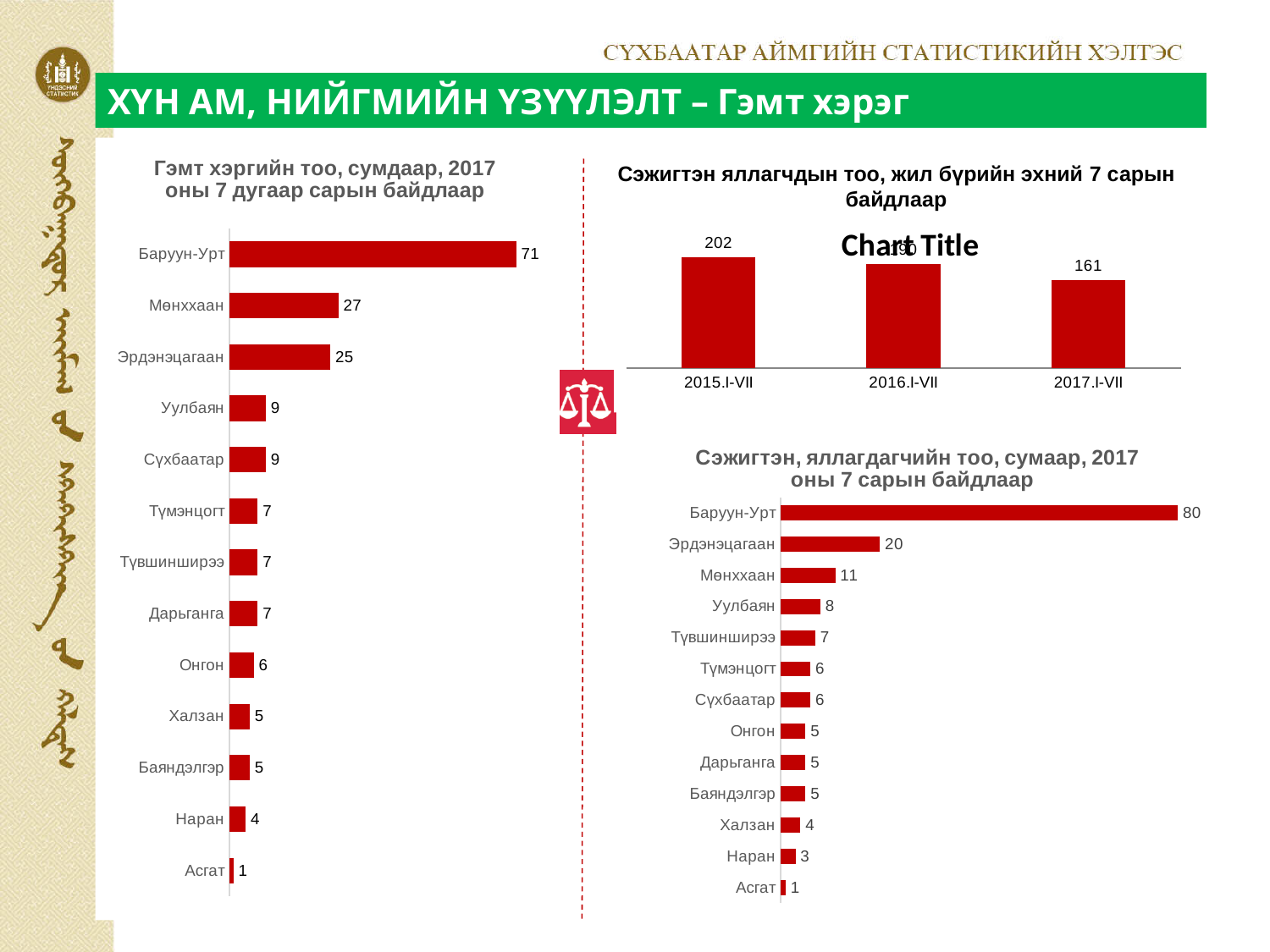
In the chart 'Гэмт хэргийн тоо, сумдаар, 2017 оны 7 дугаар сарын байдлаар', what is the value for Баруун-Урт? 71 In the chart 'Гэмт хэргийн тоо, сумдаар, 2017 оны 7 дугаар сарын байдлаар', which category has the lowest value? Асгат In the chart 'Сэжигтэн яллагчдын тоо, жил бүрийн эхний 7 сарын байдлаар', do the values rise or fall from 2015.I-VII to 2017.I-VII? fall In the chart 'Сэжигтэн яллагчдын тоо, жил бүрийн эхний 7 сарын байдлаар', what is the value for 2015.I-VII? 202 In the chart 'Сэжигтэн, яллагдагчийн тоо, сумаар, 2017 оны 7 сарын байдлаар', what is the value for Уулбаян? 8 In the chart 'Сэжигтэн, яллагдагчийн тоо, сумаар, 2017 оны 7 сарын байдлаар', which is larger, Эрдэнэцагаан or Мөнххаан? Эрдэнэцагаан In the chart 'Гэмт хэргийн тоо, сумдаар, 2017 оны 7 дугаар сарын байдлаар', what is the difference between Баруун-Урт and Мөнххаан? 44 In the chart 'Сэжигтэн яллагчдын тоо, жил бүрийн эхний 7 сарын байдлаар', what is the value for 2017.I-VII? 161 How many categories are shown in the chart 'Гэмт хэргийн тоо, сумдаар, 2017 оны 7 дугаар сарын байдлаар'? 13 What kind of chart is 'Сэжигтэн яллагчдын тоо, жил бүрийн эхний 7 сарын байдлаар'? bar chart In the chart 'Гэмт хэргийн тоо, сумдаар, 2017 оны 7 дугаар сарын байдлаар', what is the value for Эрдэнэцагаан? 25 In the chart 'Сэжигтэн, яллагдагчийн тоо, сумаар, 2017 оны 7 сарын байдлаар', what is the value for Баруун-Урт? 80